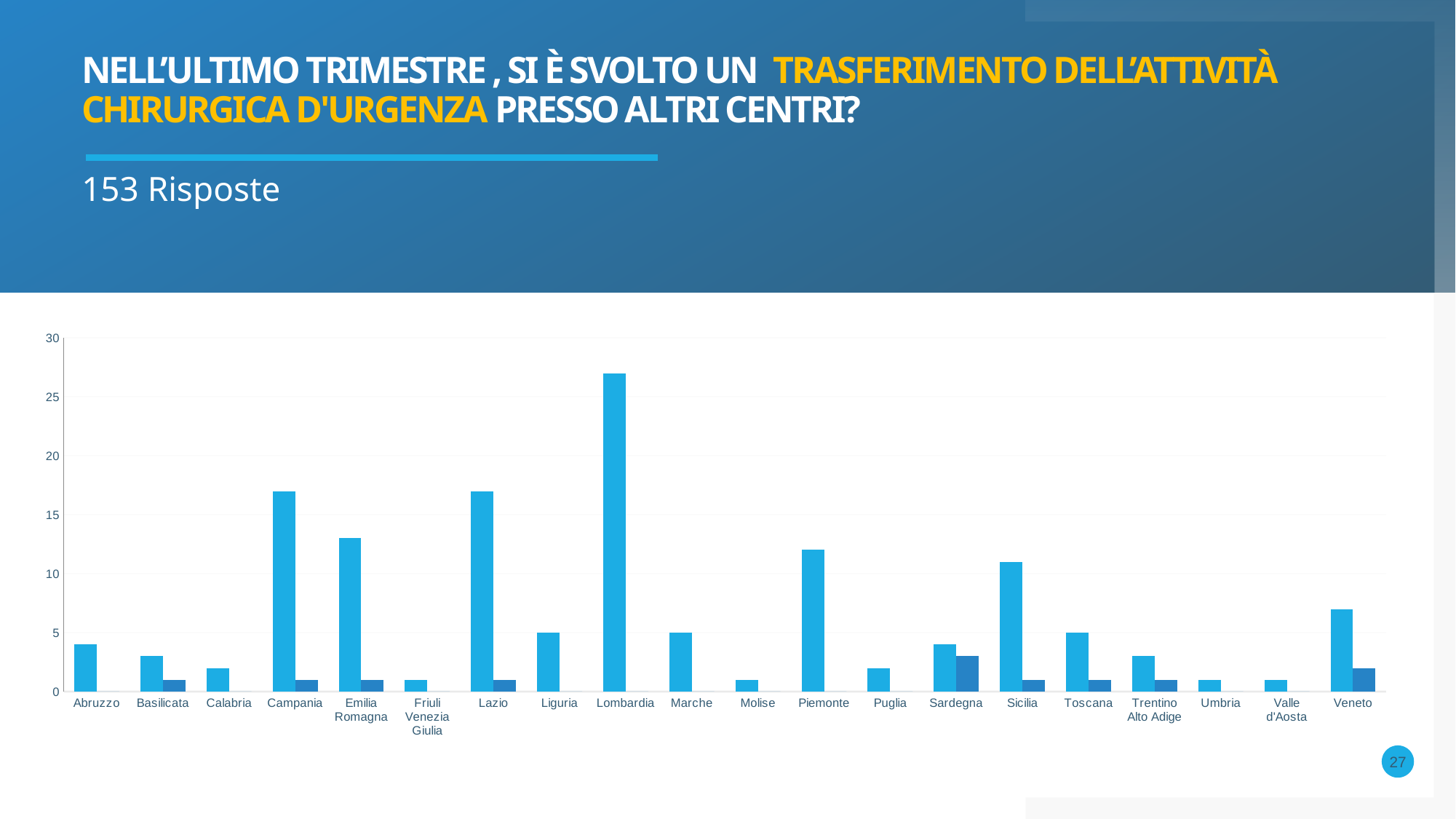
Which has the larger light-blue bar, Sicilia or Veneto? Sicilia Is the light-blue value for Piemonte greater or less than 10? greater Is the light-blue value for Lombardia greater or less than 25? greater Is the light-blue value for Abruzzo greater or less than 5? less Which region has the highest light-blue bar? Lombardia Which has the larger light-blue bar, Emilia Romagna or Sardegna? Emilia Romagna Which has the larger light-blue bar, Lombardia or Campania? Lombardia How many regions are listed along the x axis? 20 What is the highest value shown on the y axis? 30 What kind of chart is shown on the slide? bar chart